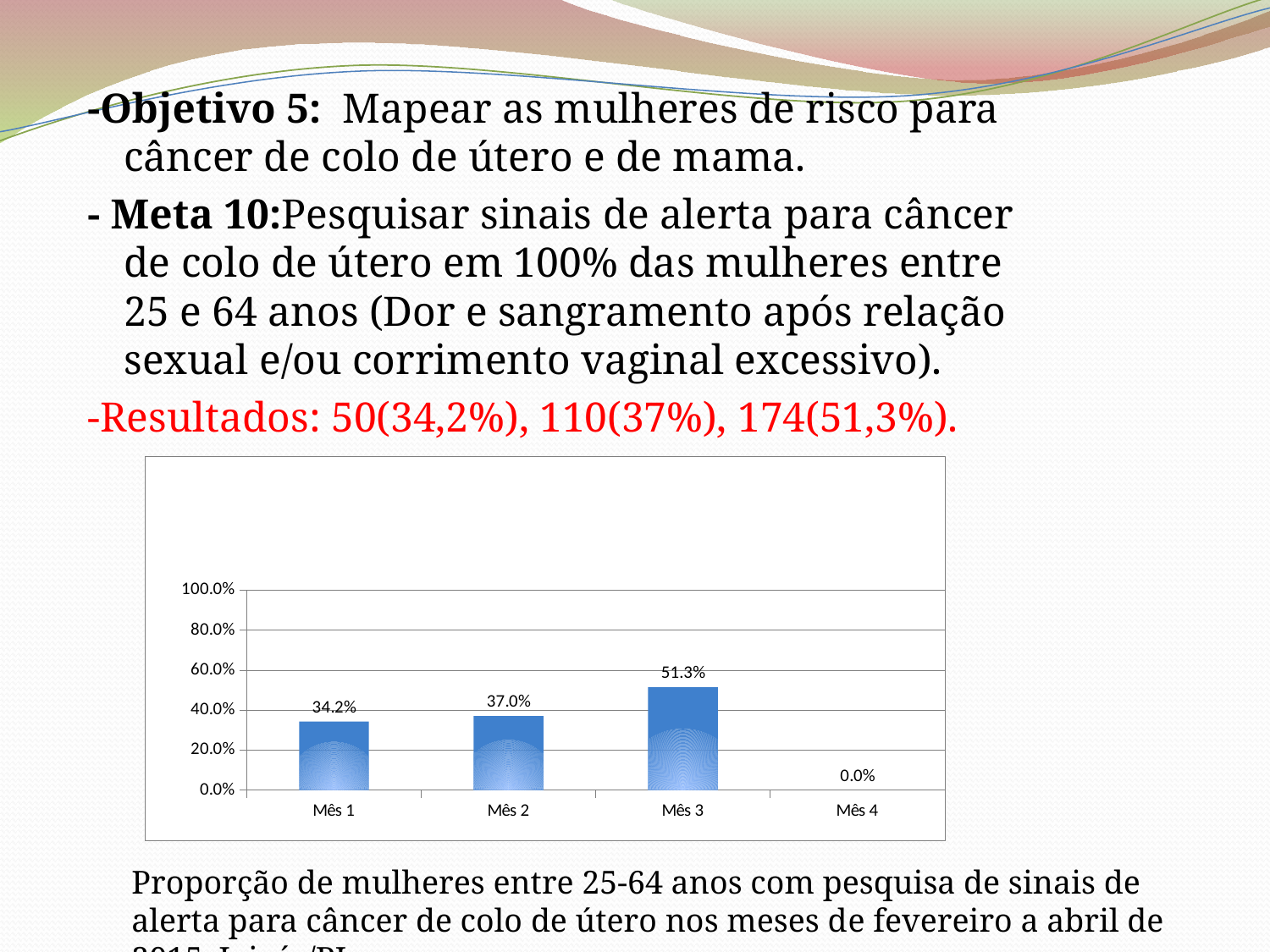
Is the value for Mês 3 greater or less than 40.0%? greater Which is larger, the value for Mês 2 or the value for Mês 3? Mês 3 Which month has the lowest value? Mês 4 Do the values rise or fall from Mês 1 to Mês 3? rise How many categories are shown on the x axis? 4 Which month has the highest value? Mês 3 What is the value for Mês 1? 34.2% What is the value for Mês 2? 37.0% What is the value for Mês 3? 51.3% What is the difference between the values for Mês 3 and Mês 1? 17.1% What kind of chart is shown on the slide? bar chart What is the value for Mês 4? 0.0%